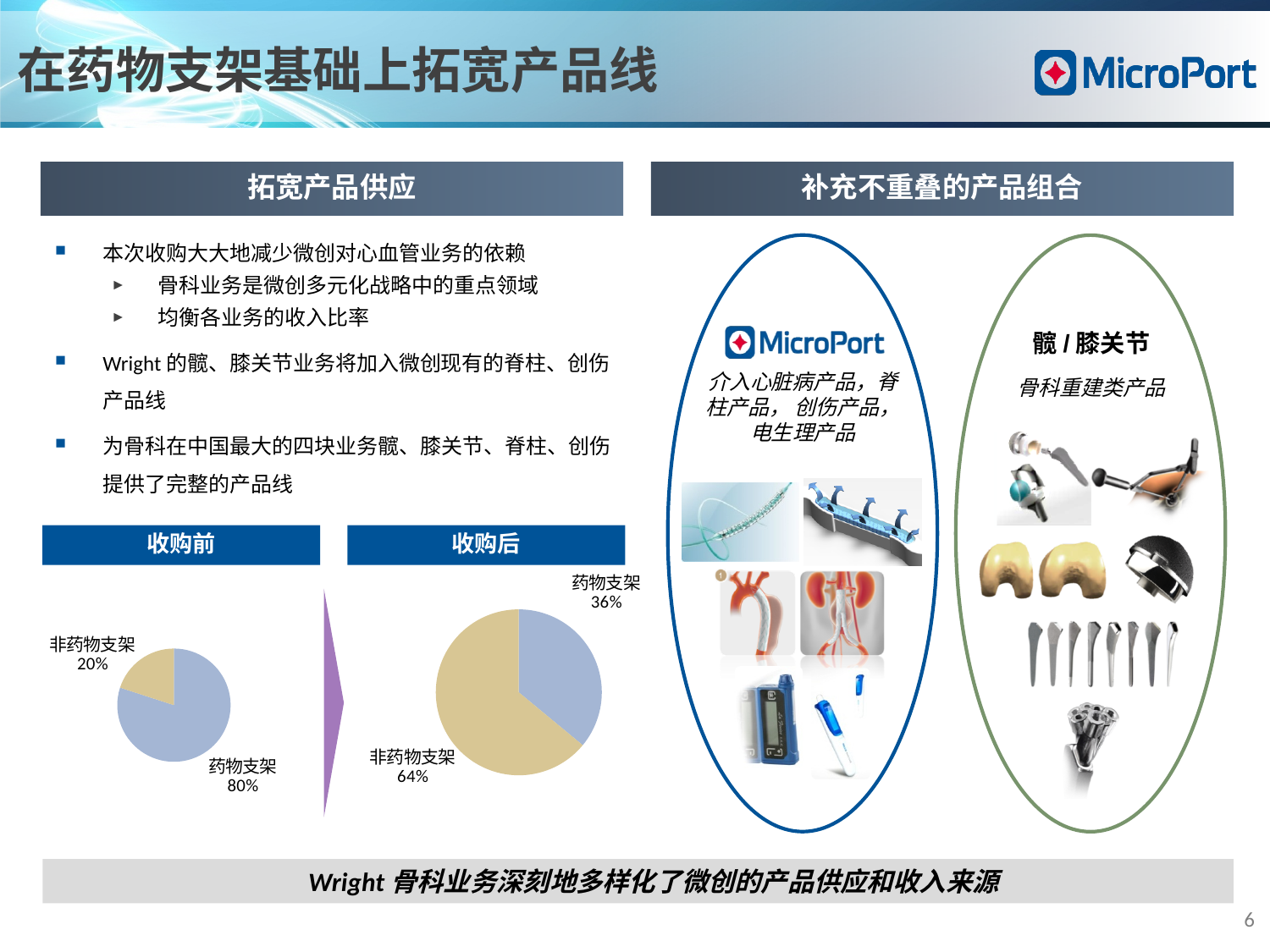
How many slices does the 收购后 pie chart have? 2 In the 收购前 pie chart, what is the difference between the 药物支架 and 非药物支架 shares? 60% In the 收购前 pie chart, what share does 非药物支架 have? 20% In the 收购前 pie chart, what share does 药物支架 have? 80% In the 收购后 pie chart, what share does 非药物支架 have? 64% What kind of chart is used for 收购前 and 收购后? Pie chart What is the title of the pie chart on the right of the two pie charts? 收购后 In the 收购前 pie chart, which slice is the largest? 药物支架 In the 收购后 pie chart, what is the difference between the 非药物支架 and 药物支架 shares? 28% In the 收购后 pie chart, what share does 药物支架 have? 36% In the 收购后 pie chart, which slice is the smallest? 药物支架 Is the 药物支架 share larger in the 收购前 chart or the 收购后 chart? 收购前